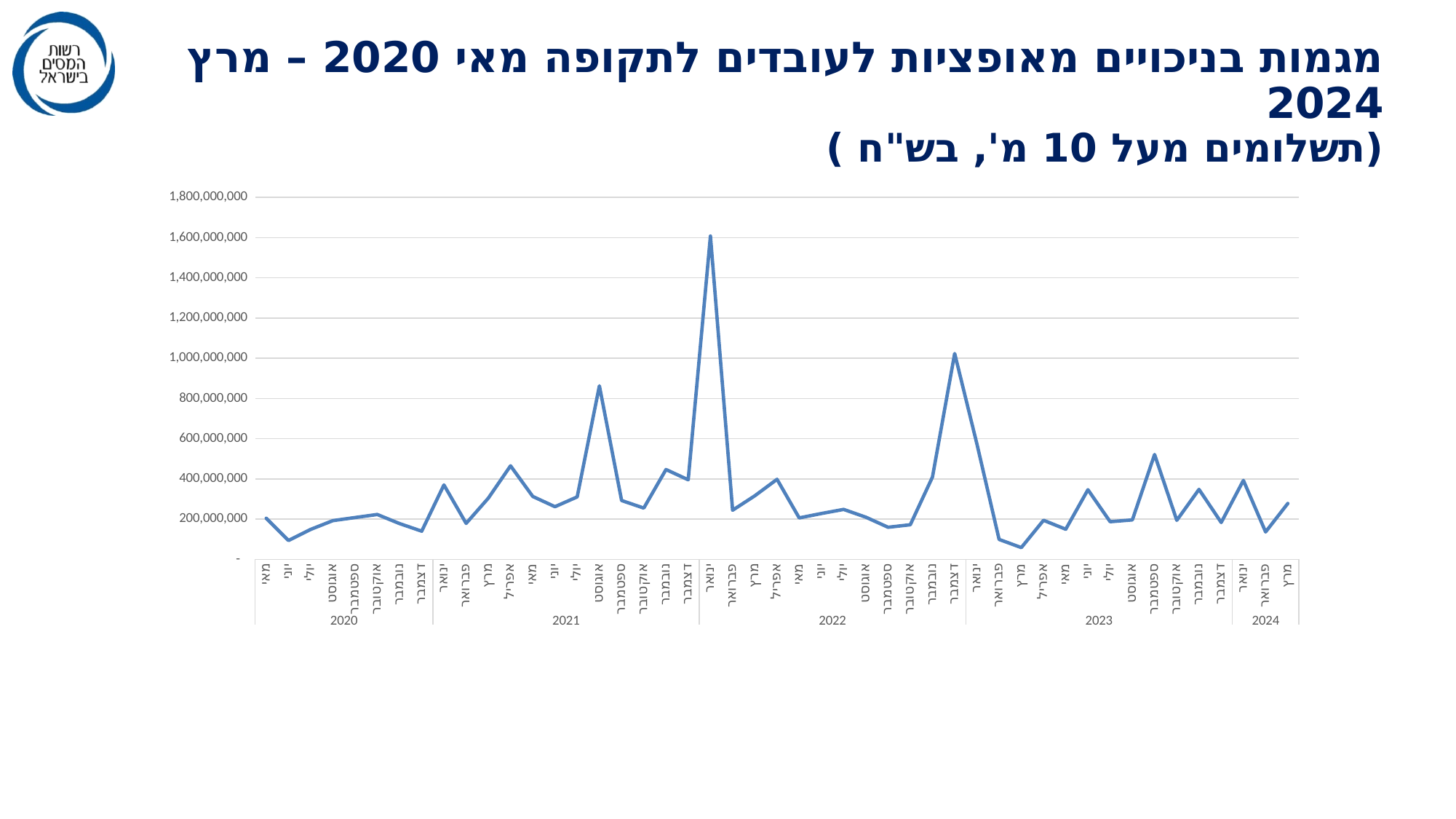
Is the value for דצמבר 2022 (December 2022) greater or less than 800,000,000? greater What is the highest tick value shown on the y axis? 1,800,000,000 Which is larger, the value for ינואר 2022 (January 2022) or the value for דצמבר 2022 (December 2022)? ינואר 2022 (January 2022) Which month has the highest value on the chart? ינואר 2022 (January 2022) Is the value for ינואר 2022 (January 2022) greater or less than 1,400,000,000? greater What kind of chart is shown on the slide? line chart Is the value for אוגוסט 2021 (August 2021) greater or less than 600,000,000? greater How many data series (lines) are plotted on the chart? 1 Which is larger, the value for אוגוסט 2021 (August 2021) or the value for דצמבר 2022 (December 2022)? דצמבר 2022 (December 2022) How many year groups are labelled along the x axis? 5